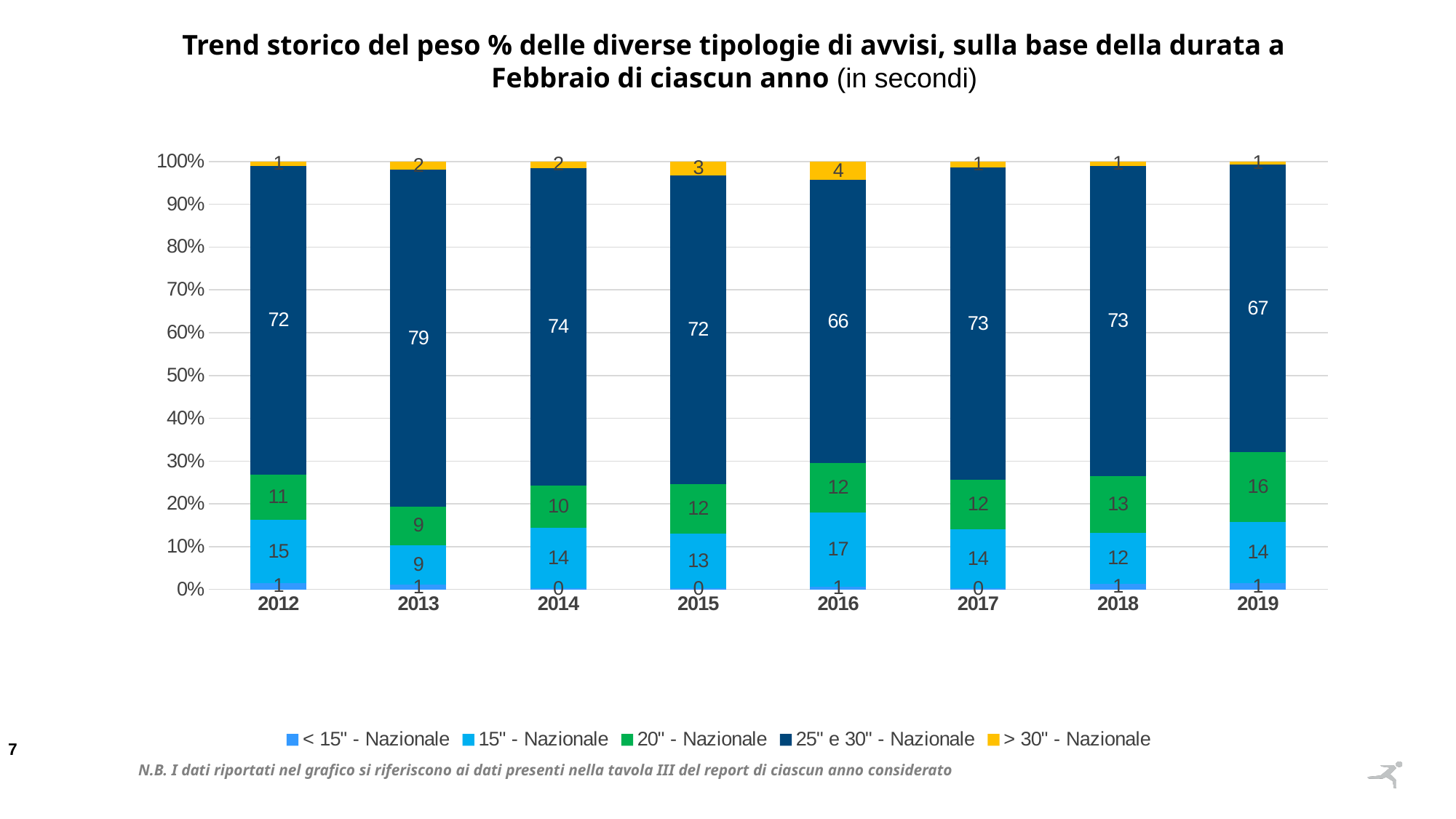
Which is larger, the "20'' - Nazionale" value in 2012 or in 2018? 2018 What is the value for the "20'' - Nazionale" series in 2019? 16 In which year is the "25'' e 30'' - Nazionale" series highest? 2013 In which year is the "> 30'' - Nazionale" series highest? 2016 How many series does the legend list? 5 What is the value for the "25'' e 30'' - Nazionale" series in 2013? 79 What is the difference between the "25'' e 30'' - Nazionale" values in 2013 and 2019? 12 What is the value for the "> 30'' - Nazionale" series in 2015? 3 What kind of chart is shown on the slide? Stacked bar chart What is the value for the "15'' - Nazionale" series in 2016? 17 In which year is the "25'' e 30'' - Nazionale" series lowest? 2016 How many years are shown on the x axis? 8